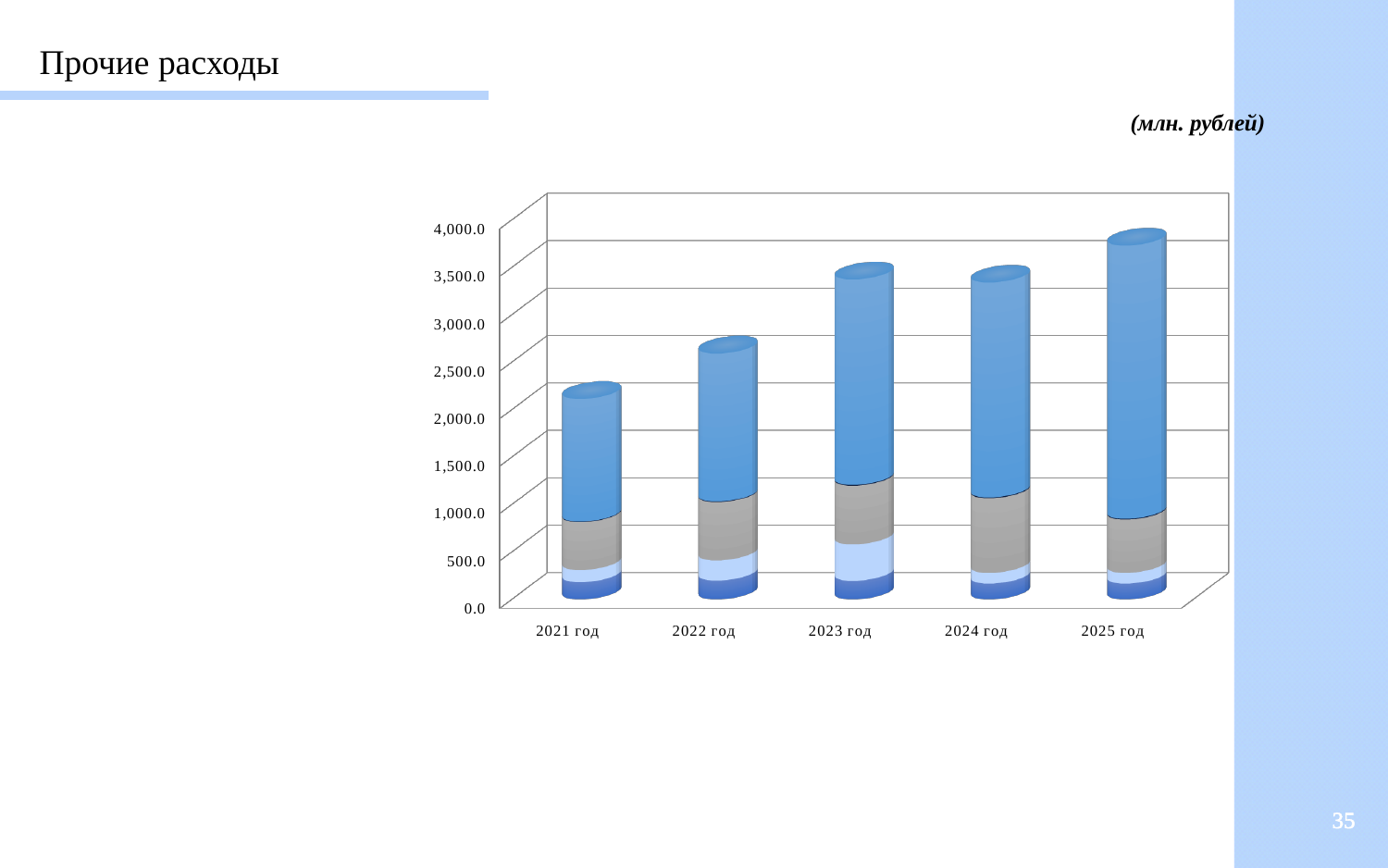
Is the total bar for 2021 год greater or less than 2,500.0? less Is the total bar for 2022 год greater or less than 2,000.0? greater Is the total bar for 2025 год greater or less than 3,500.0? greater Which bar is taller, 2022 год or 2025 год? 2025 год Which year has the tallest bar in the chart? 2025 год Which year has the shortest bar in the chart? 2021 год What kind of chart is shown on the slide? Stacked bar chart How many years (categories) are shown on the x axis of the chart? 5 Do the bar totals generally rise or fall from 2021 год to 2025 год? rise In what units are the values in the chart expressed, according to the slide? млн. рублей